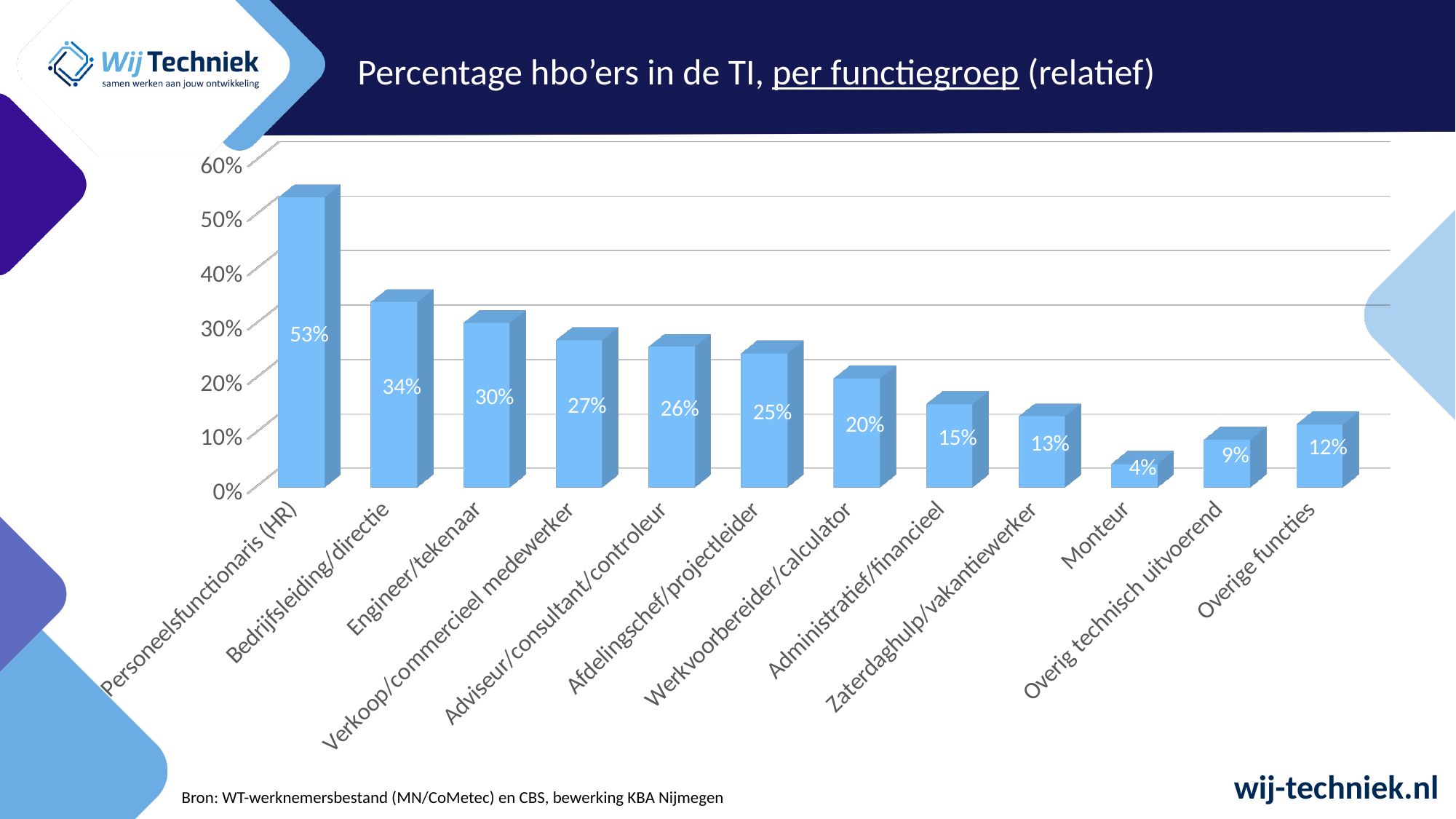
How many categories are shown on the chart? 12 Is the value for Werkvoorbereider/calculator greater or less than 30%? less Which category has the lowest value? Monteur Which is larger, the value for Zaterdaghulp/vakantiewerker or the value for Overig technisch uitvoerend? Zaterdaghulp/vakantiewerker What is the value for Engineer/tekenaar? 30% What kind of chart is shown on the slide? bar chart What is the title of the chart? Percentage hbo'ers in de TI, per functiegroep (relatief) What is the difference between the values for Bedrijfsleiding/directie and Administratief/financieel? 19% Which category has the highest value? Personeelsfunctionaris (HR) What is the value for Personeelsfunctionaris (HR)? 53% What is the value for Monteur? 4% What is the value for Overige functies? 12%